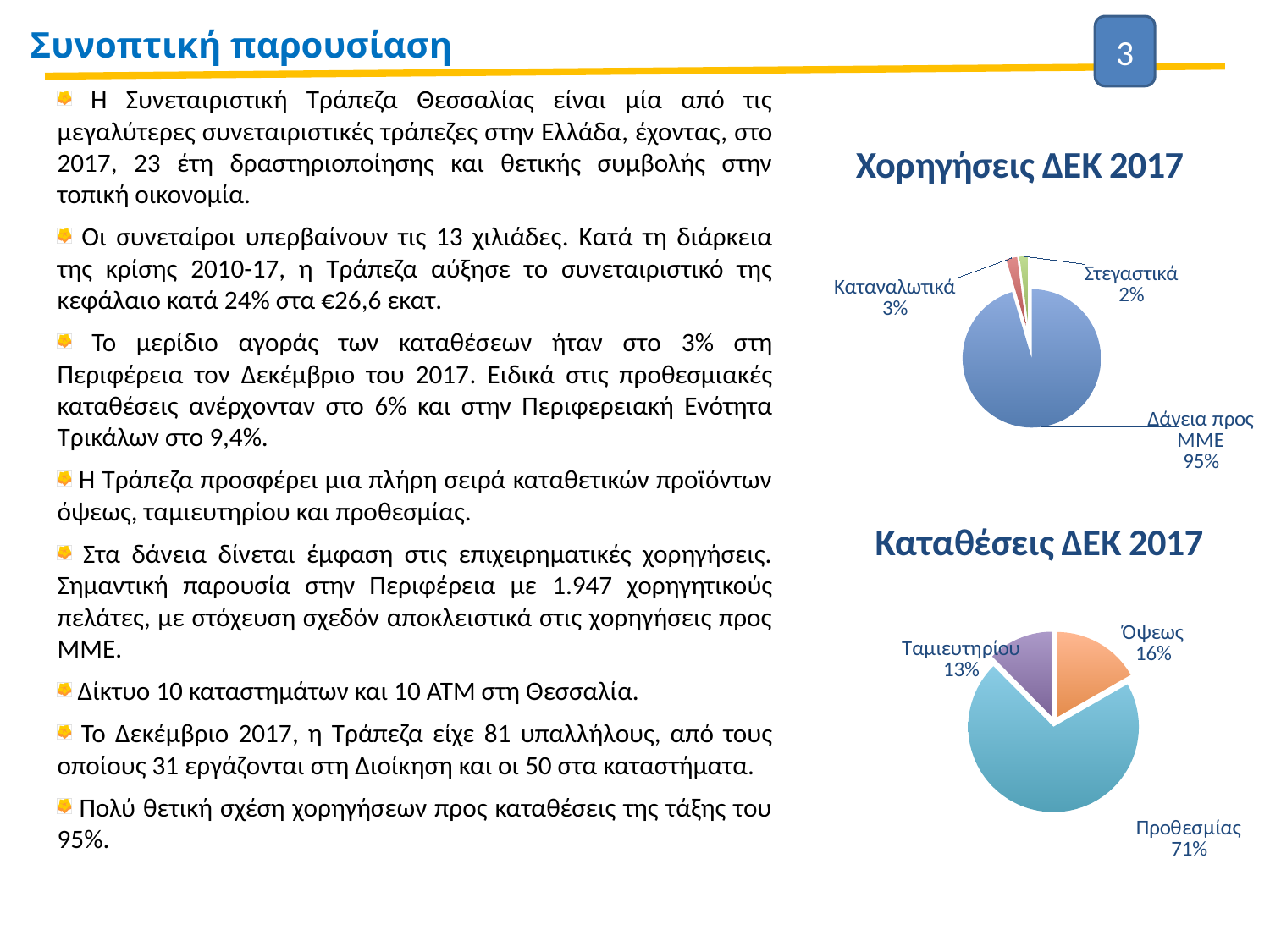
In the 'Χορηγήσεις ΔΕΚ 2017' chart, what share is shown for Δάνεια προς ΜΜΕ? 95% How many pie charts are shown on the slide? 2 In the 'Καταθέσεις ΔΕΚ 2017' chart, what is the difference in percentage points between Προθεσμίας and Όψεως? 55 percentage points In the 'Καταθέσεις ΔΕΚ 2017' chart, what share is shown for Ταμιευτηρίου? 13% In the 'Χορηγήσεις ΔΕΚ 2017' chart, which category has the smallest slice? Στεγαστικά In the 'Χορηγήσεις ΔΕΚ 2017' chart, what is the difference in percentage points between Καταναλωτικά and Στεγαστικά? 1 percentage point In the 'Χορηγήσεις ΔΕΚ 2017' chart, what share is shown for Καταναλωτικά? 3% What kind of chart is 'Χορηγήσεις ΔΕΚ 2017'? Pie chart In the 'Καταθέσεις ΔΕΚ 2017' chart, which is larger: Όψεως or Ταμιευτηρίου? Όψεως In the 'Καταθέσεις ΔΕΚ 2017' chart, what share is shown for Προθεσμίας? 71% In the 'Καταθέσεις ΔΕΚ 2017' chart, which category has the largest slice? Προθεσμίας In the 'Χορηγήσεις ΔΕΚ 2017' chart, how many slices does the pie have? 3